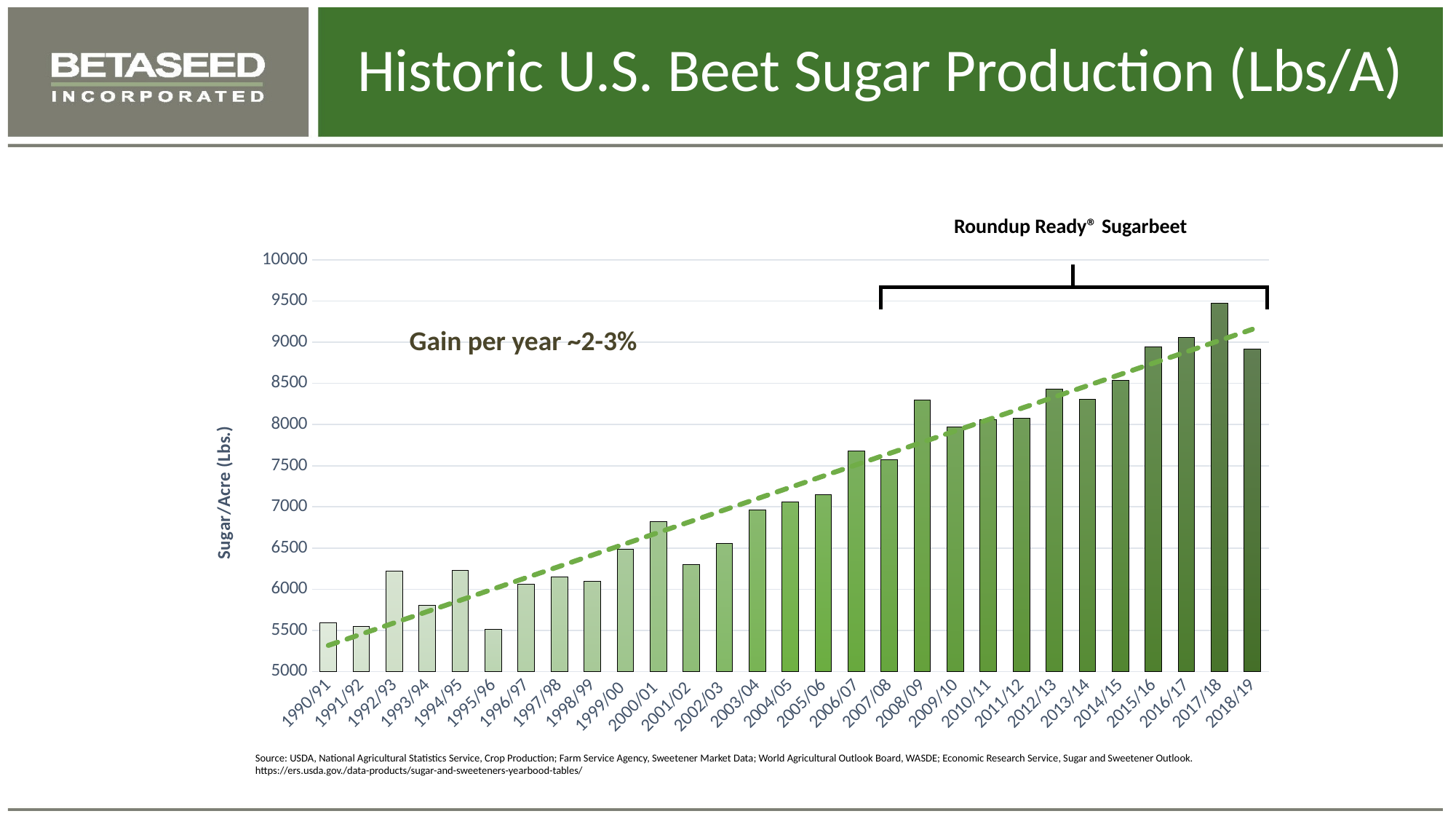
What is the label on the vertical axis of the chart? Sugar/Acre (Lbs.) Which is larger, the value for 1995/96 or the value for 1996/97? 1996/97 Is the value for 2008/09 greater or less than 8000? greater Is the value for 2001/02 greater or less than 6500? less Is the value for 2006/07 greater or less than 7500? greater What kind of chart is shown on the slide? Bar chart Overall, do the values rise or fall from 1990/91 to 2018/19? Rise Which is larger, the value for 2017/18 or the value for 2018/19? 2017/18 Which crop year has the highest beet sugar production? 2017/18 How many crop years (bars) are plotted on the chart? 29